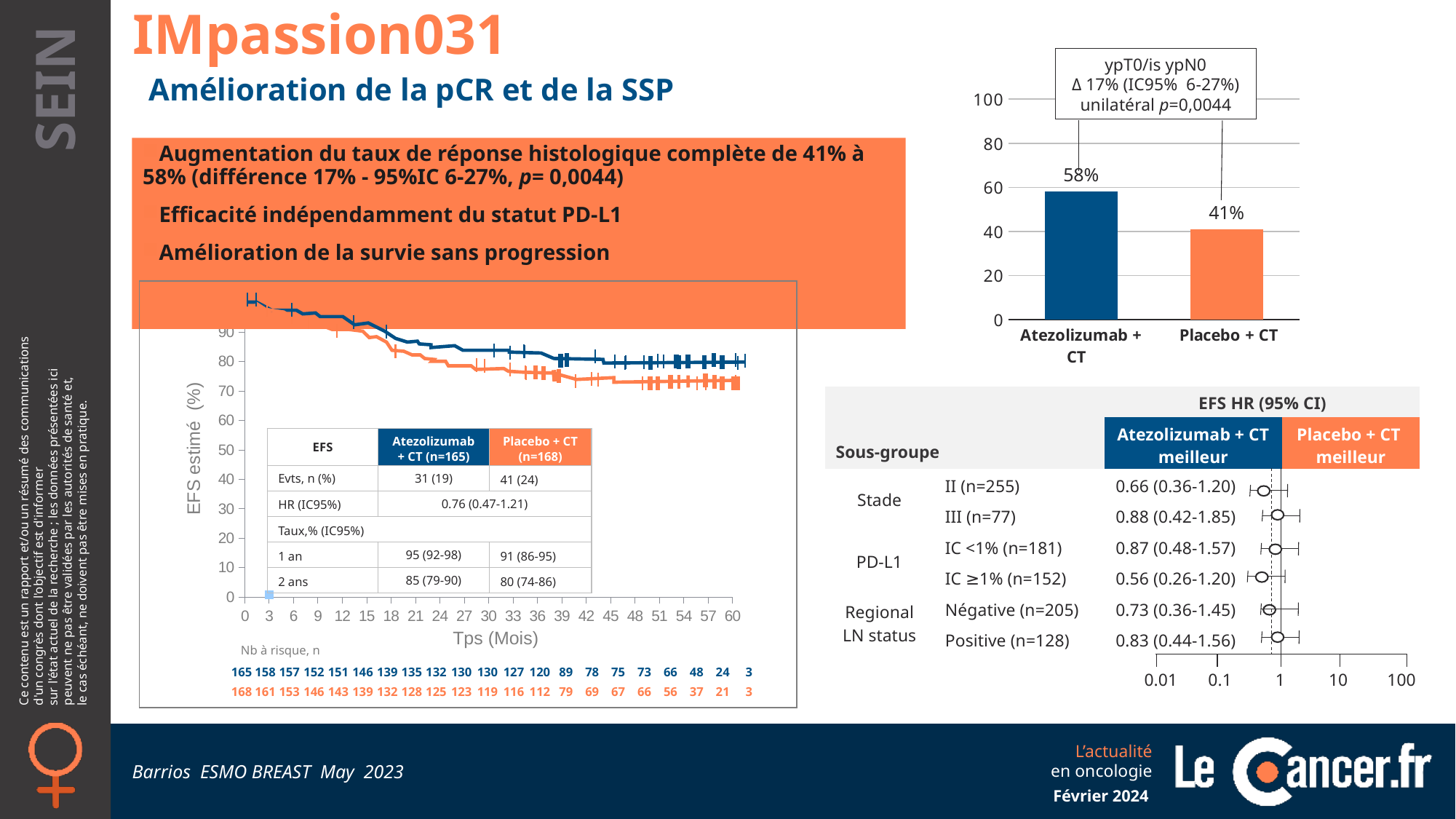
In the bar chart at the top right, what is the difference between the Atezolizumab + CT and Placebo + CT values? 17% In the forest plot at the bottom right, which subgroup has the lowest hazard ratio? PD-L1 IC ≥1% (n=152) In the EFS chart at the bottom left, how many treatment arms are plotted? 2 In the bar chart at the top right, what is the pCR rate for Placebo + CT? 41% How many bars are shown in the bar chart at the top right? 2 In the EFS chart at the bottom left, do the curves rise or fall as time increases? fall In the forest plot at the bottom right, what is the EFS HR (95% CI) for Stade II (n=255)? 0.66 (0.36-1.20) In the bar chart at the top right, is the value for Placebo + CT greater or less than 60? less What kind of chart is the chart at the top right of the slide? bar chart In the bar chart at the top right, which arm has the higher value? Atezolizumab + CT In the EFS chart at the bottom left, what is the label of the x axis? Tps (Mois) In the bar chart at the top right, what is the pCR rate for Atezolizumab + CT? 58%